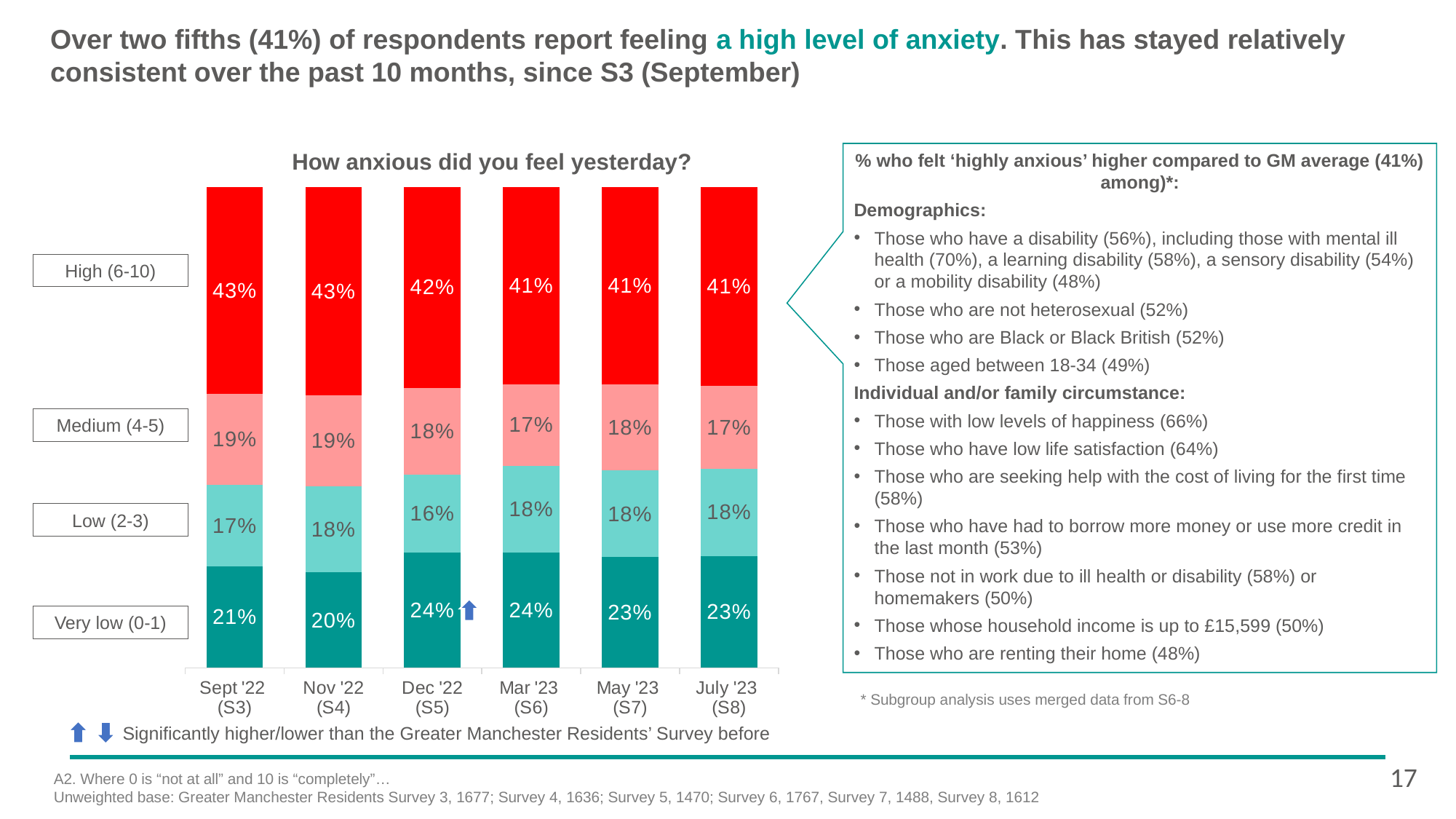
How many anxiety level categories are stacked in each bar? 4 Which survey wave has a blue upward arrow next to its Very low (0-1) label? Dec '22 (S5) How many survey waves are shown on the x axis of the chart? 6 In which survey wave is the Very low (0-1) share the smallest? Nov '22 (S4) What percentage of respondents reported Medium (4-5) anxiety in Mar '23 (S6)? 17% What percentage of respondents reported High (6-10) anxiety in Sept '22 (S3)? 43% What percentage of respondents reported Very low (0-1) anxiety in Dec '22 (S5)? 24% By how many percentage points did the High (6-10) share fall from Sept '22 (S3) to July '23 (S8)? 2 percentage points In which survey wave is the Low (2-3) share the smallest? Dec '22 (S5) Does the High (6-10) share rise or fall from Sept '22 (S3) to July '23 (S8)? Fall What type of chart is used to show 'How anxious did you feel yesterday?' Stacked bar chart Which has the larger Very low (0-1) share, Nov '22 (S4) or Dec '22 (S5)? Dec '22 (S5)